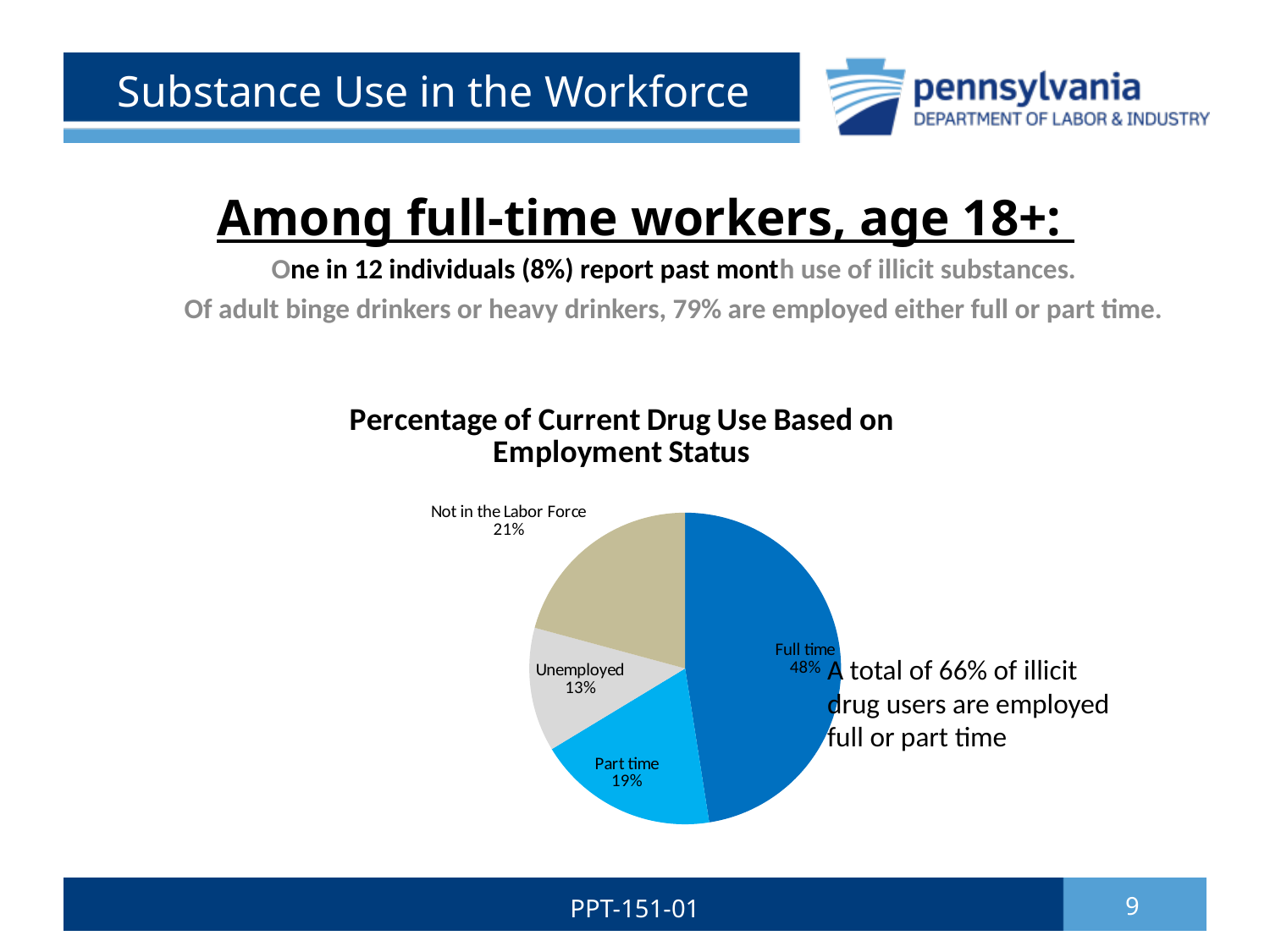
Which is larger, the Not in the Labor Force slice or the Part time slice? Not in the Labor Force Which employment status has the smallest slice of the pie? Unemployed What is the title of the chart? Percentage of Current Drug Use Based on Employment Status Which employment status has the largest slice of the pie? Full time What type of chart is shown on the slide? Pie chart What percentage of the pie is labelled Part time? 19% What percentage of the pie is labelled Full time? 48% What percentage of the pie is labelled Unemployed? 13% What is the combined share of the Full time and Part time slices? 67% What is the difference between the Full time and Part time percentages? 29% What percentage of the pie is labelled Not in the Labor Force? 21% How many slices does the pie chart have? 4